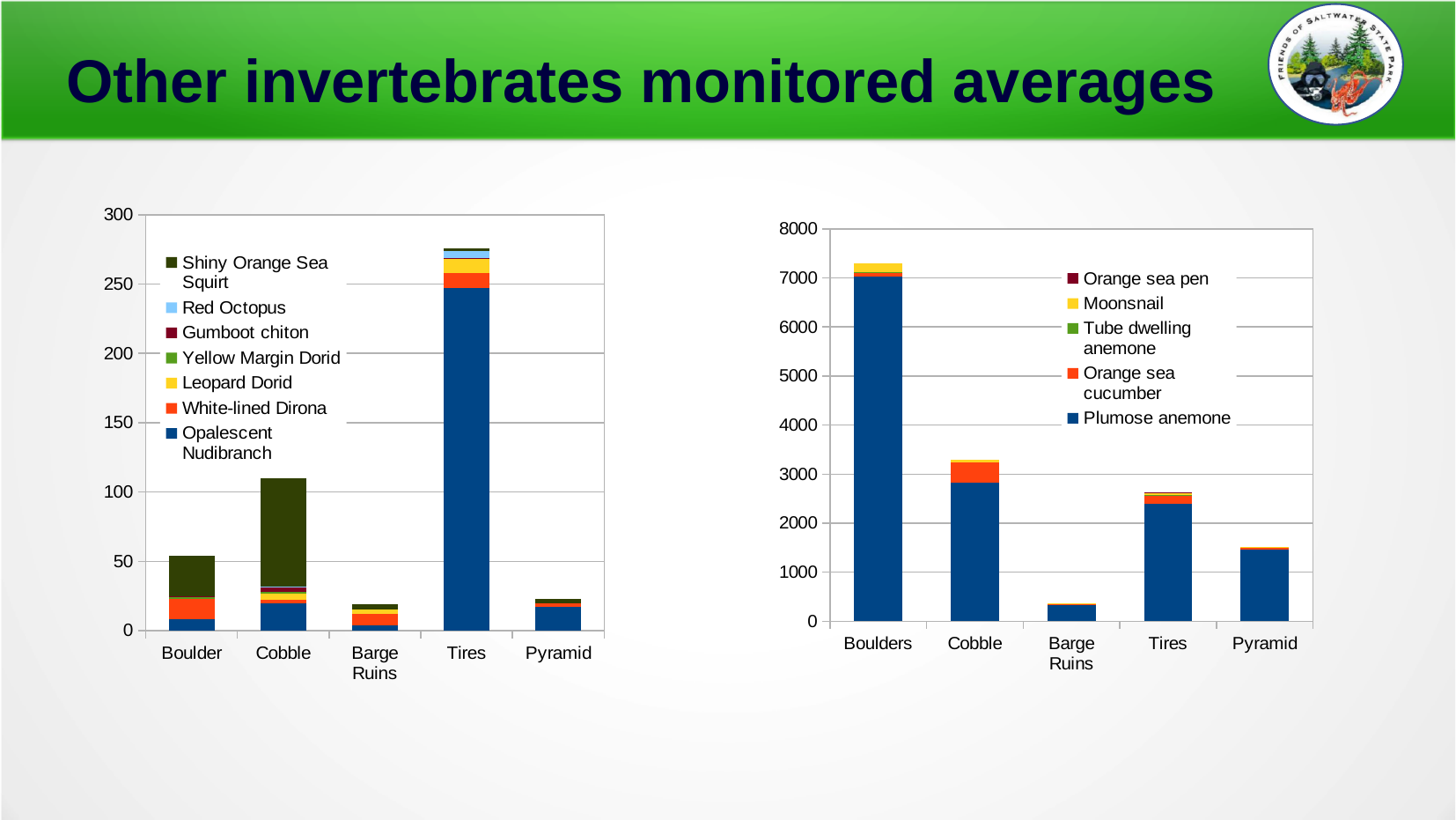
In the left chart, which series is shown in dark green? Shiny Orange Sea Squirt How many categories are shown on the x axis of the right chart? 5 In the right chart, which has the larger total, Tires or Pyramid? Tires In the right chart, is the total for Pyramid greater or less than 1000? greater What kind of chart is the left chart? stacked bar chart In the left chart, which category has the tallest stacked bar? Tires In the right chart, which category has the tallest stacked bar? Boulders In the left chart, is the total for Tires greater or less than 250? greater How many series does the legend of the left chart list? 7 How many series does the legend of the right chart list? 5 In the right chart, which category has the shortest stacked bar? Barge Ruins In the left chart, is the total for Boulder greater or less than 100? less